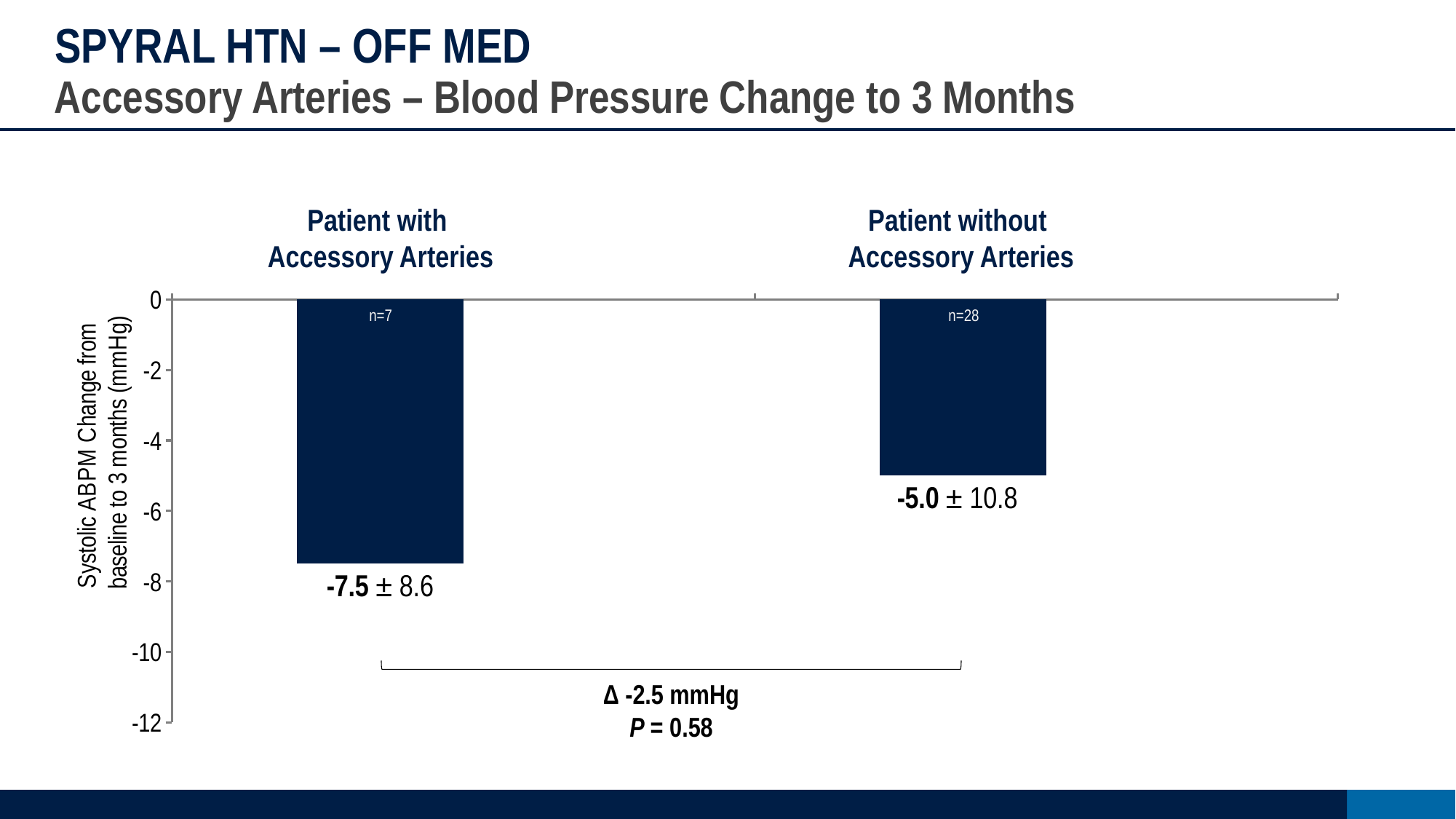
What is the systolic ABPM change for patients with accessory arteries? -7.5 How many bars are plotted on the chart? 2 What is the P value shown for the comparison between the two groups? P = 0.58 What is the systolic ABPM change for patients without accessory arteries? -5.0 What is the label of the y axis? Systolic ABPM Change from baseline to 3 months (mmHg) How many patients are in the group with accessory arteries? n=7 How many patients are in the group without accessory arteries? n=28 What is the difference (Δ) between the two groups shown on the chart? -2.5 mmHg Which group shows the larger reduction in systolic ABPM? Patient with Accessory Arteries What is the standard deviation shown for patients without accessory arteries? 10.8 What is the standard deviation shown for patients with accessory arteries? 8.6 What kind of chart is shown on the slide? Bar chart